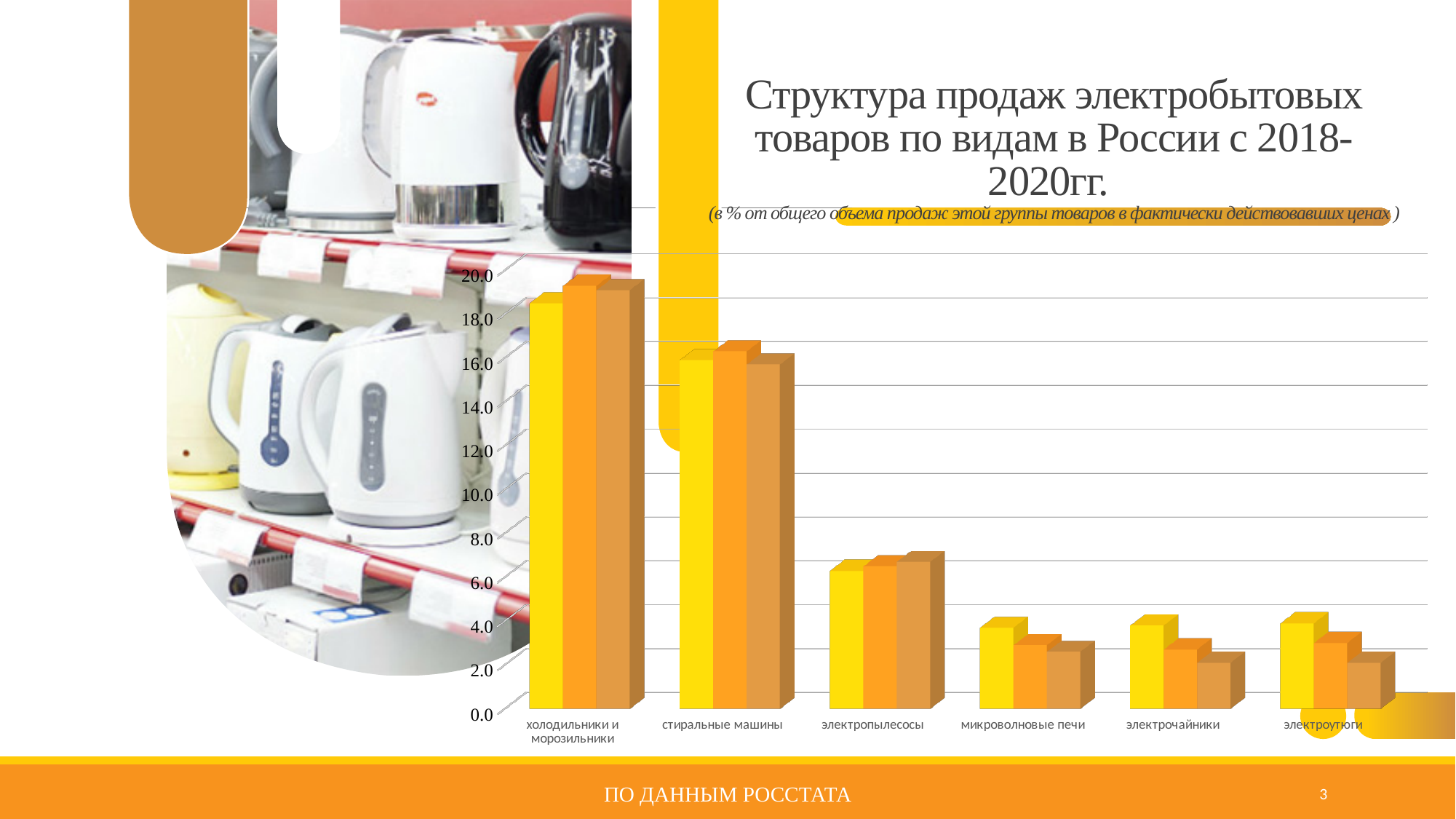
Do the bar heights generally rise or fall moving from left to right along the x axis? fall Which category has higher bars: электропылесосы or микроволновые печи? электропылесосы Which category has the highest bars in the chart? холодильники и морозильники Are the bars for электроутюги greater or less than 6.0? less How many product categories are shown on the x axis of the chart? 6 Which category has higher bars: холодильники и морозильники or стиральные машины? холодильники и морозильники Are the bars for стиральные машины greater or less than 14.0? greater How many bars are shown for each category in the chart? 3 Are the bars for холодильники и морозильники greater or less than 18.0? greater What is the title of the chart on the slide? Структура продаж электробытовых товаров по видам в России с 2018-2020гг. What kind of chart is shown on the slide? bar chart